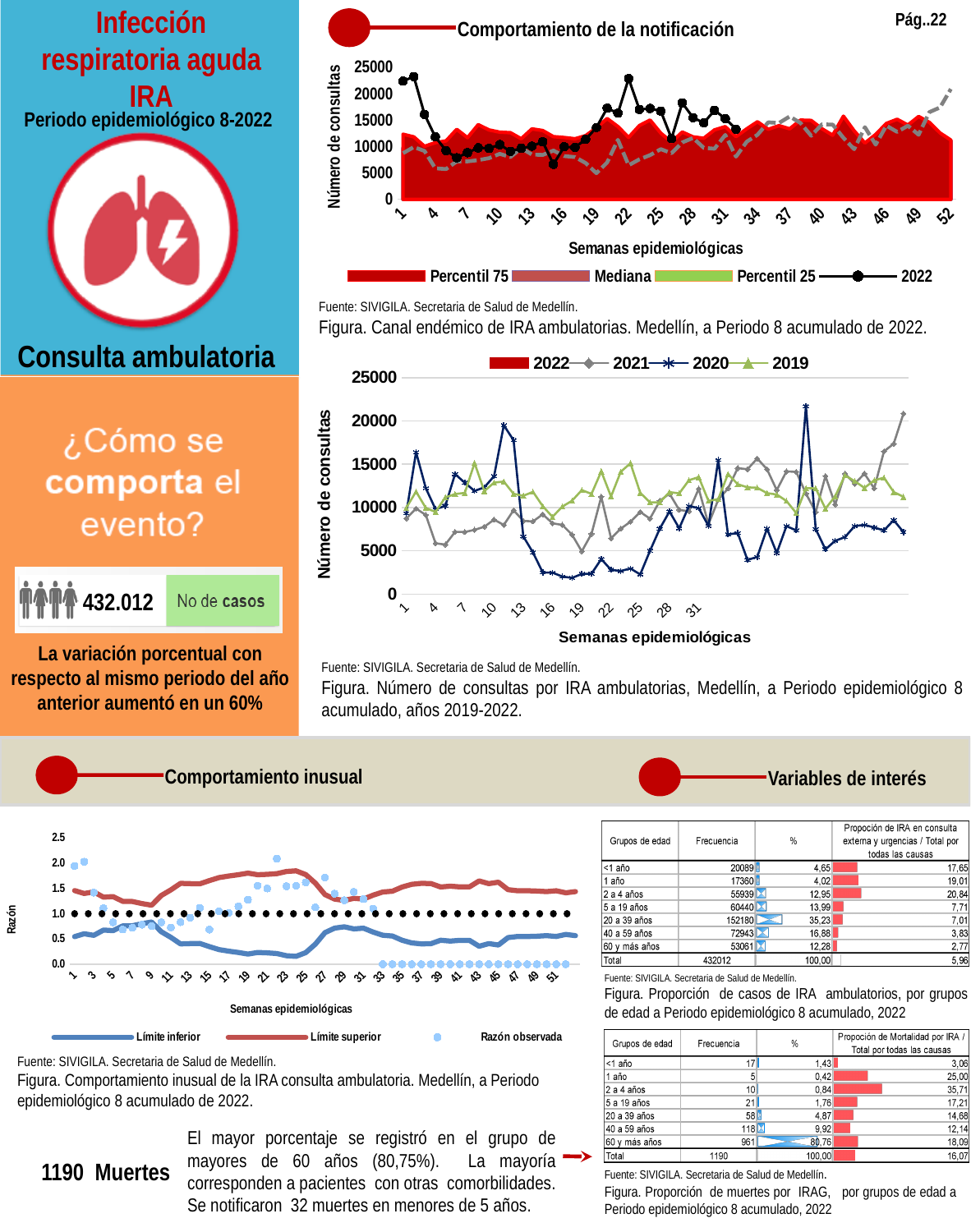
In the chart of consultas por IRA ambulatorias for 2019-2022, is the 2021 value at week 4 greater or less than 10000? less In the chart of consultas por IRA ambulatorias for 2019-2022, how many series does the legend list? 4 In the chart of consultas por IRA ambulatorias for 2019-2022, is the 2020 value at week 16 greater or less than 5000? less In the 'Comportamiento inusual' chart, how many series does the legend list? 3 In the chart of consultas por IRA ambulatorias for 2019-2022, what kind of chart is it? line chart In the 'Comportamiento de la notificación' chart, how many series does the legend list? 4 In the 'Comportamiento inusual' chart, is the Razón observada value at week 1 greater or less than 1.5? greater In the 'Comportamiento inusual' chart, does the Límite inferior line rise or fall between week 9 and week 23? fall In the 'Comportamiento de la notificación' chart, what is the label of the y axis? Número de consultas